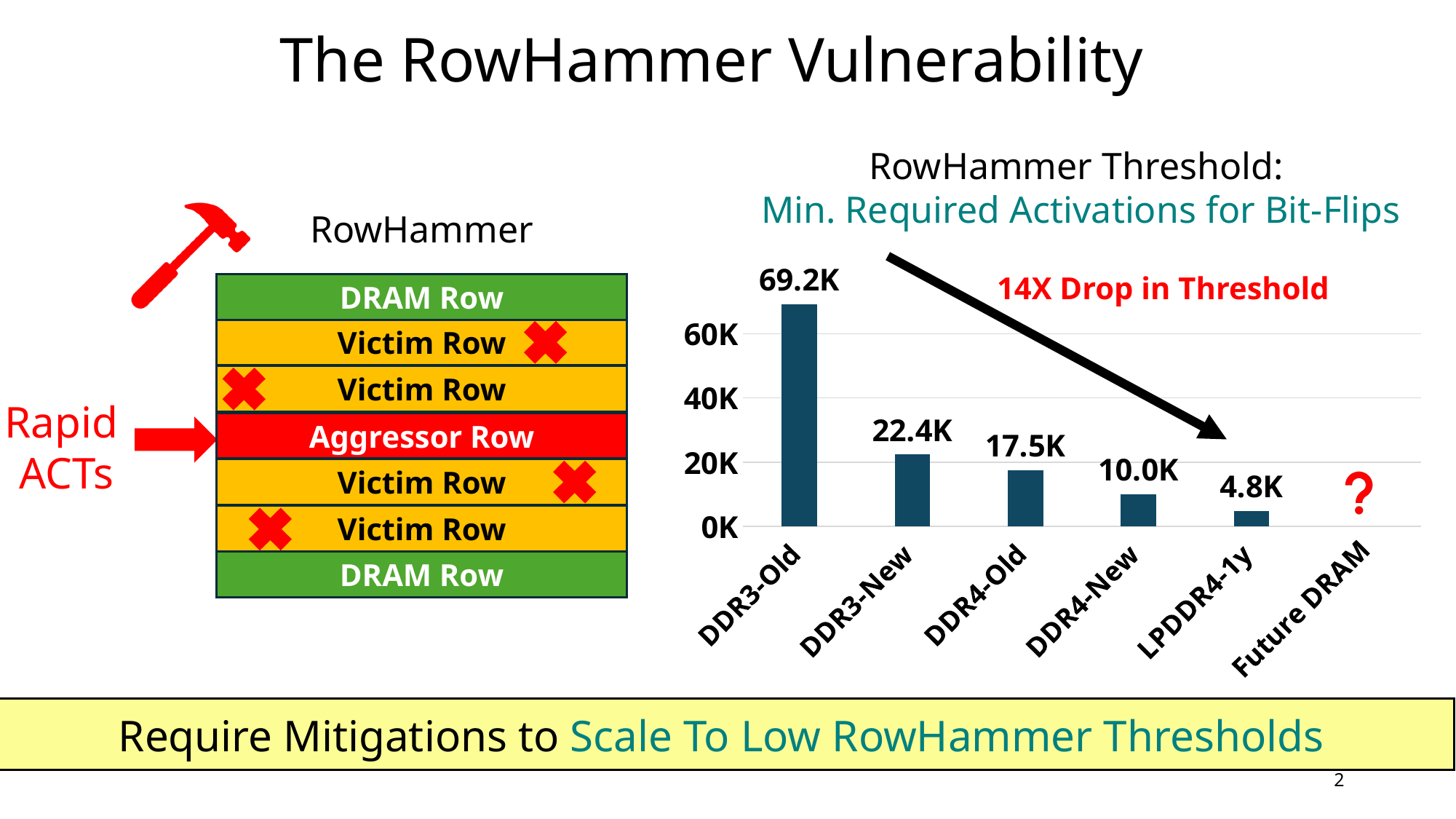
What is the value shown for LPDDR4-1y? 4.8K Among the categories with a plotted bar, which has the lowest RowHammer threshold? LPDDR4-1y Which is larger, the value for DDR3-New or the value for DDR4-Old? DDR3-New What is the difference between the DDR4-Old and DDR4-New values? 7.5K What is the value shown for DDR4-New in the RowHammer Threshold chart? 10.0K What kind of chart is used to show the RowHammer threshold? Bar chart What drop in threshold does the red annotation on the chart state? 14X Drop in Threshold How many categories are listed on the x axis of the RowHammer Threshold chart? 6 Which category has the highest RowHammer threshold in the chart? DDR3-Old Do the RowHammer threshold values rise or fall from DDR3-Old to LPDDR4-1y? Fall What is the difference between the DDR3-Old and DDR3-New values? 46.8K What is the RowHammer threshold value shown for DDR3-Old? 69.2K